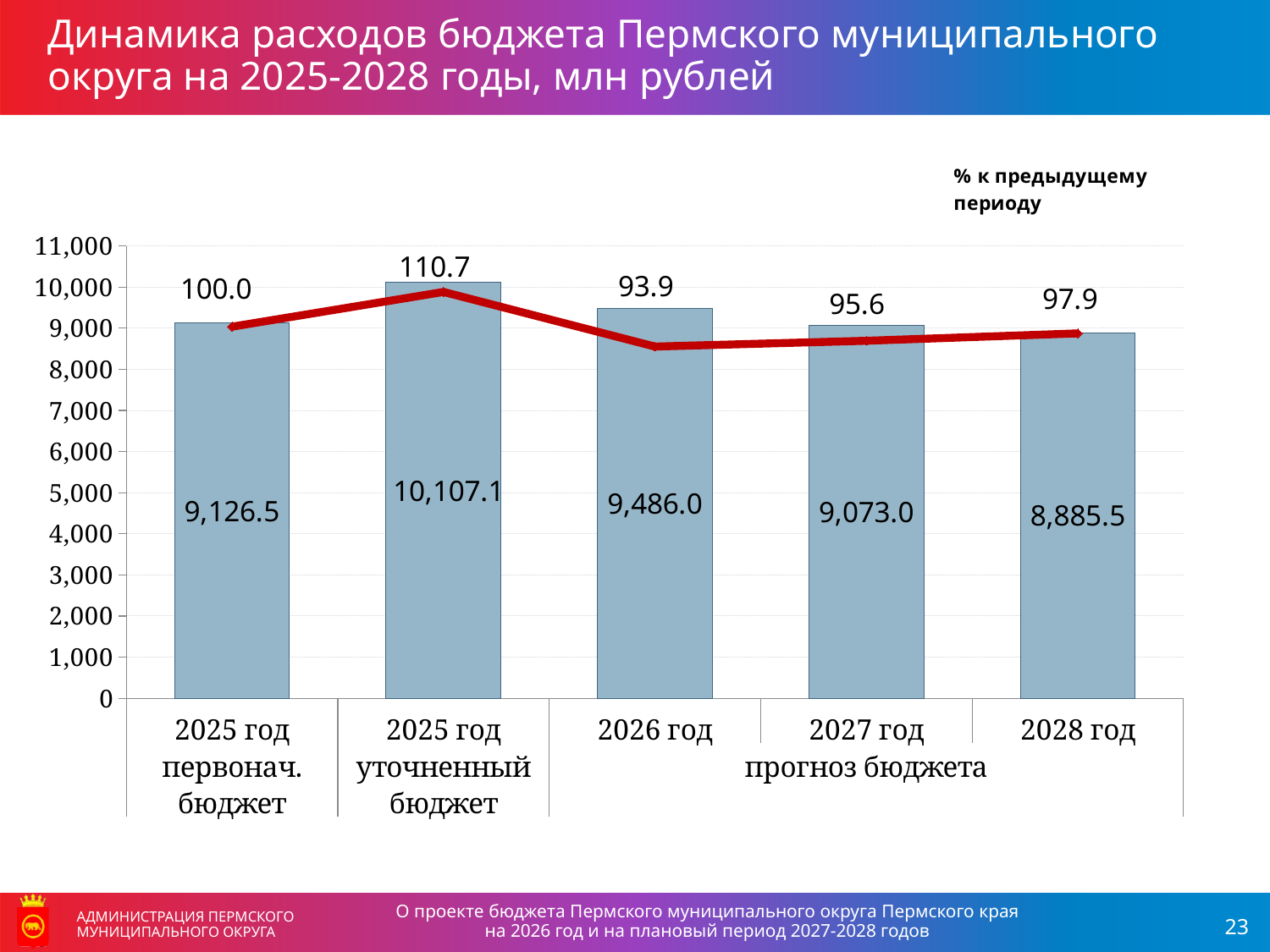
What is the difference between the 2026 год bar and the 2027 год bar? 413.0 Which category has the lowest bar value? 2028 год What is the budget expenditure value shown for the 2025 год уточненный бюджет bar? 10,107.1 Which is larger, the bar value for 2026 год or for 2027 год? 2026 год Do the bar values rise or fall from 2026 год to 2028 год? fall What percentage to the previous period is shown on the line for 2027 год? 95.6 What is the difference between the 2025 год уточненный бюджет bar and the 2025 год первонач. бюджет bar? 980.6 What percentage to the previous period is shown on the line for 2026 год? 93.9 Which category has the highest bar value? 2025 год уточненный бюджет How many bars are plotted on the chart? 5 What unit is stated in the chart title for the expenditure values? млн рублей What is the value shown for the 2028 год bar? 8,885.5